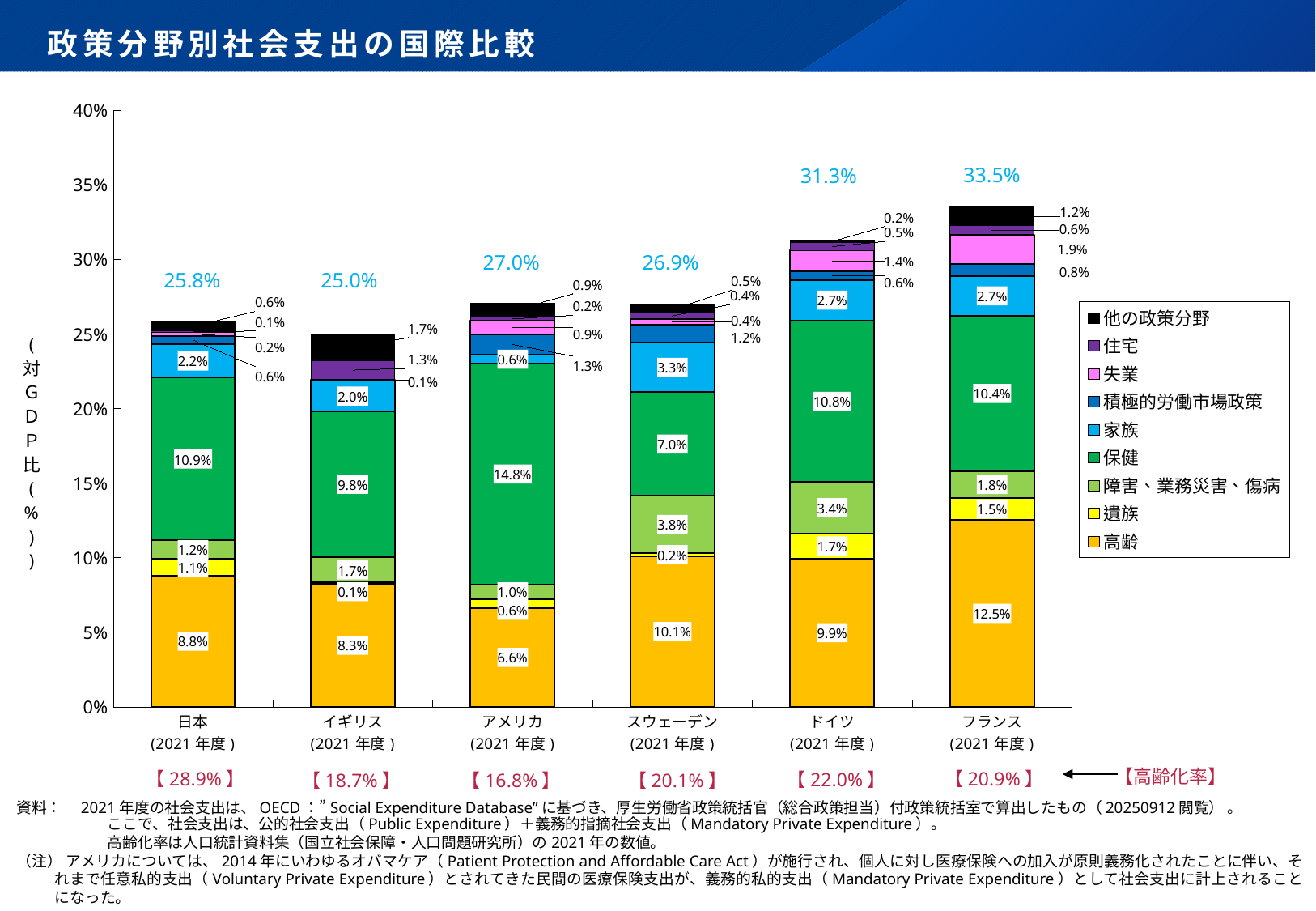
Is the total social expenditure for ドイツ greater or less than 30%? greater Which country has the highest total social expenditure as a share of GDP? フランス What kind of chart is shown on the slide? stacked bar chart Which country has the lowest total social expenditure as a share of GDP? イギリス What is the value of the 高齢 segment for スウェーデン? 10.1% How many countries are shown on the x axis of the chart? 6 Which is larger, the 家族 segment for スウェーデン or the 家族 segment for 日本? スウェーデン What is the total social expenditure (% of GDP) shown above the bar for イギリス? 25.0% What is the total social expenditure (% of GDP) shown above the bar for フランス? 33.5% What is the value of the 保健 segment for アメリカ? 14.8% What is the difference between the 高齢 segment for フランス and the 高齢 segment for 日本? 3.7% How many series does the legend list? 9